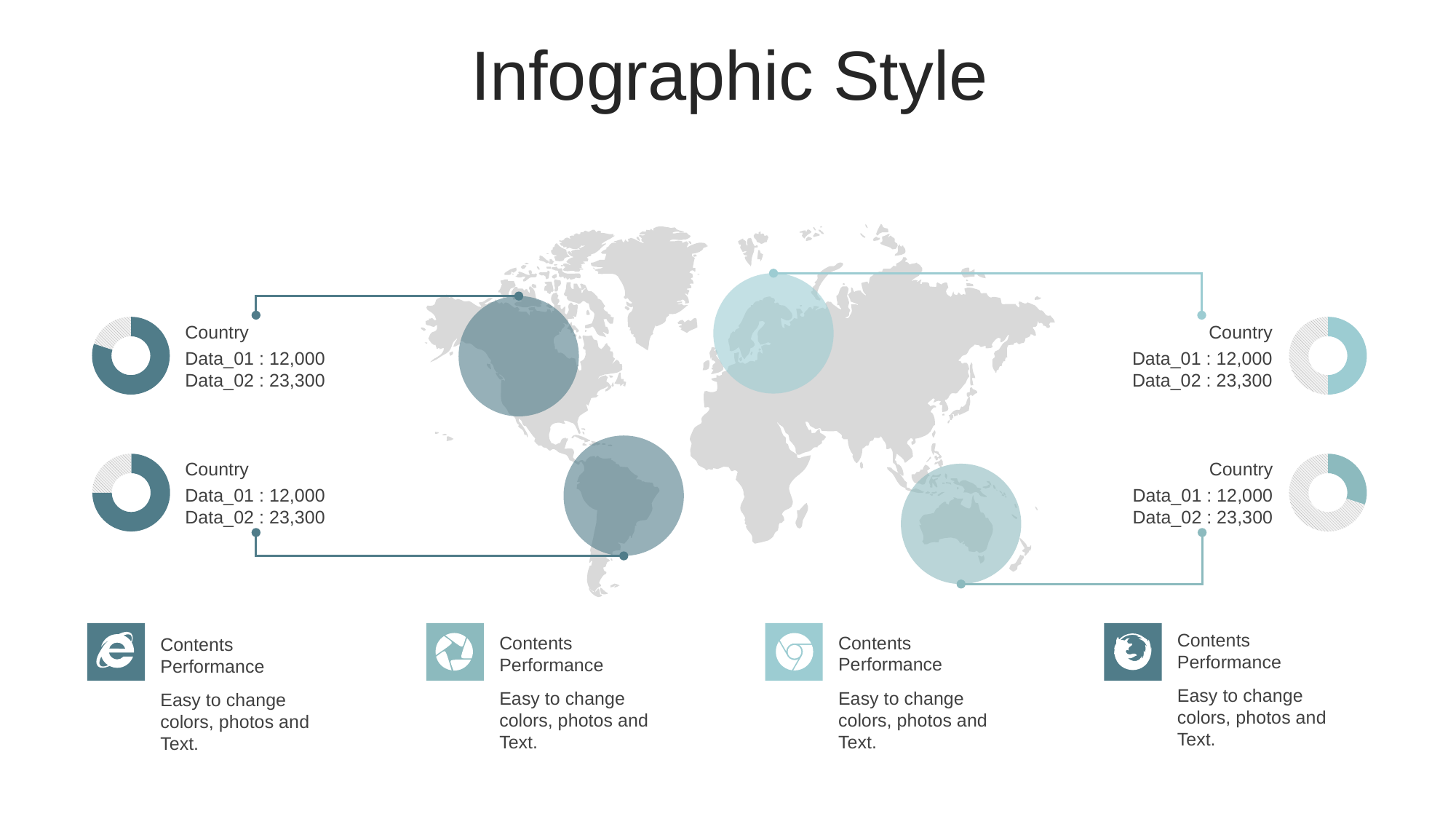
What kind of chart are the four small charts beside the map on the slide? Donut (pie) chart For the top-left donut chart, what is the value printed for Data_02? 23,300 How many data items are listed next to each donut chart? 2 For the top-left donut chart, what is the value printed for Data_01? 12,000 How many small donut charts are shown on the slide? 4 For the bottom-right donut chart, what is the value printed for Data_02? 23,300 What label is printed above the data values next to each donut chart? Country For the top-right donut chart, what is the value printed for Data_01? 12,000 For the top-right donut chart, what is the difference between Data_02 and Data_01? 11,300 For the bottom-left donut chart, which is larger, Data_01 or Data_02? Data_02